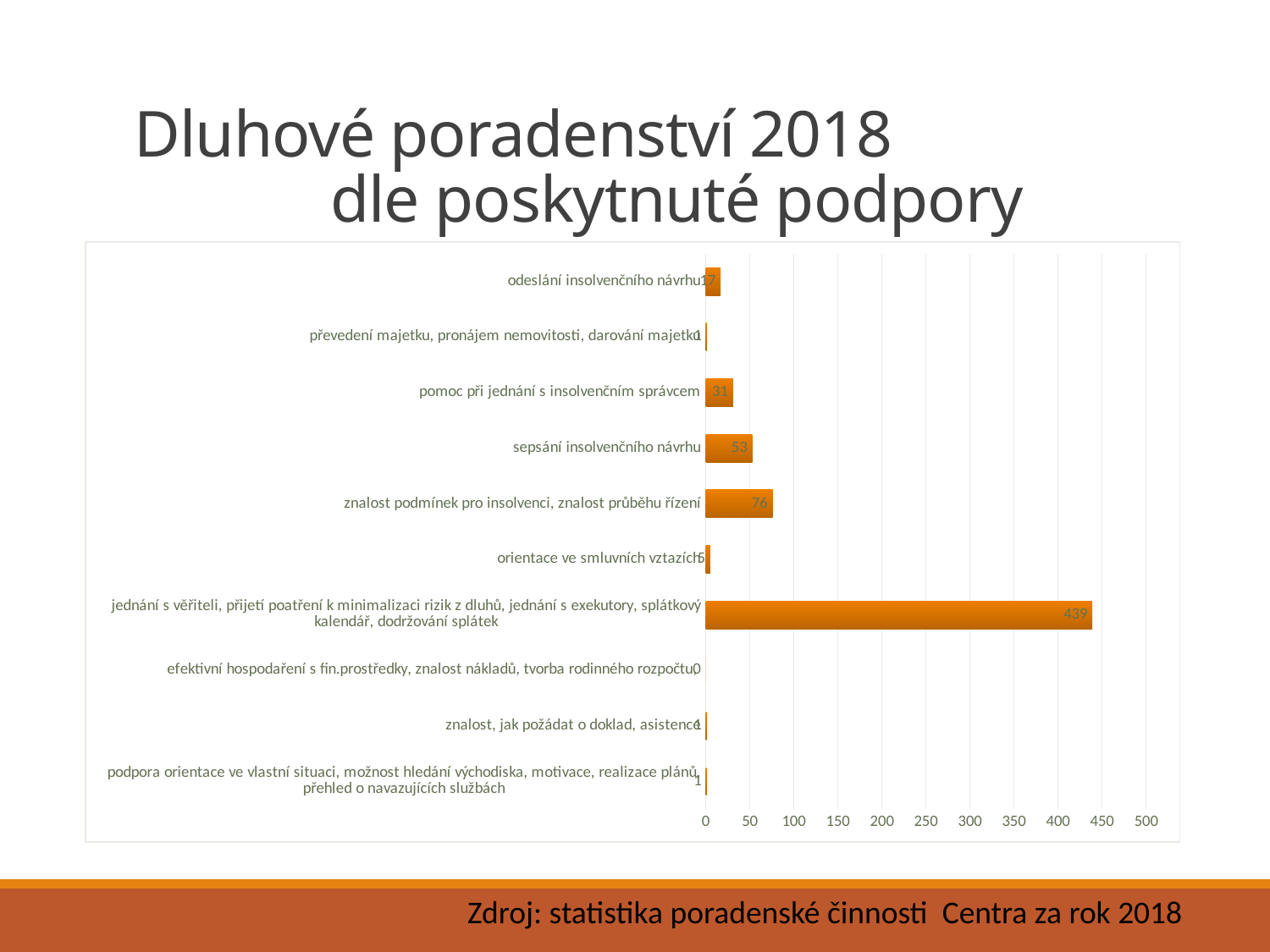
What is the value for 'efektivní hospodaření s fin.prostředky, znalost nákladů, tvorba rodinného rozpočtu'? 0 What is the value for 'znalost podmínek pro insolvenci, znalost průběhu řízení'? 76 What is the value for 'jednání s věřiteli, přijetí poatření k minimalizaci rizik z dluhů, jednání s exekutory, splátkový kalendář, dodržování splátek'? 439 What is the title of the slide? Dluhové poradenství 2018 dle poskytnuté podpory What is the difference between the values for 'znalost podmínek pro insolvenci, znalost průběhu řízení' and 'sepsání insolvenčního návrhu'? 23 How many categories are shown in the chart? 10 What is the value for 'sepsání insolvenčního návrhu'? 53 Which is larger: the value for 'sepsání insolvenčního návrhu' or the value for 'pomoc při jednání s insolvenčním správcem'? sepsání insolvenčního návrhu Is the value for 'jednání s věřiteli, přijetí poatření k minimalizaci rizik z dluhů, jednání s exekutory, splátkový kalendář, dodržování splátek' greater or less than 400? greater What is the value for 'pomoc při jednání s insolvenčním správcem'? 31 Which category has the highest value? jednání s věřiteli, přijetí poatření k minimalizaci rizik z dluhů, jednání s exekutory, splátkový kalendář, dodržování splátek What kind of chart is shown on the slide? bar chart